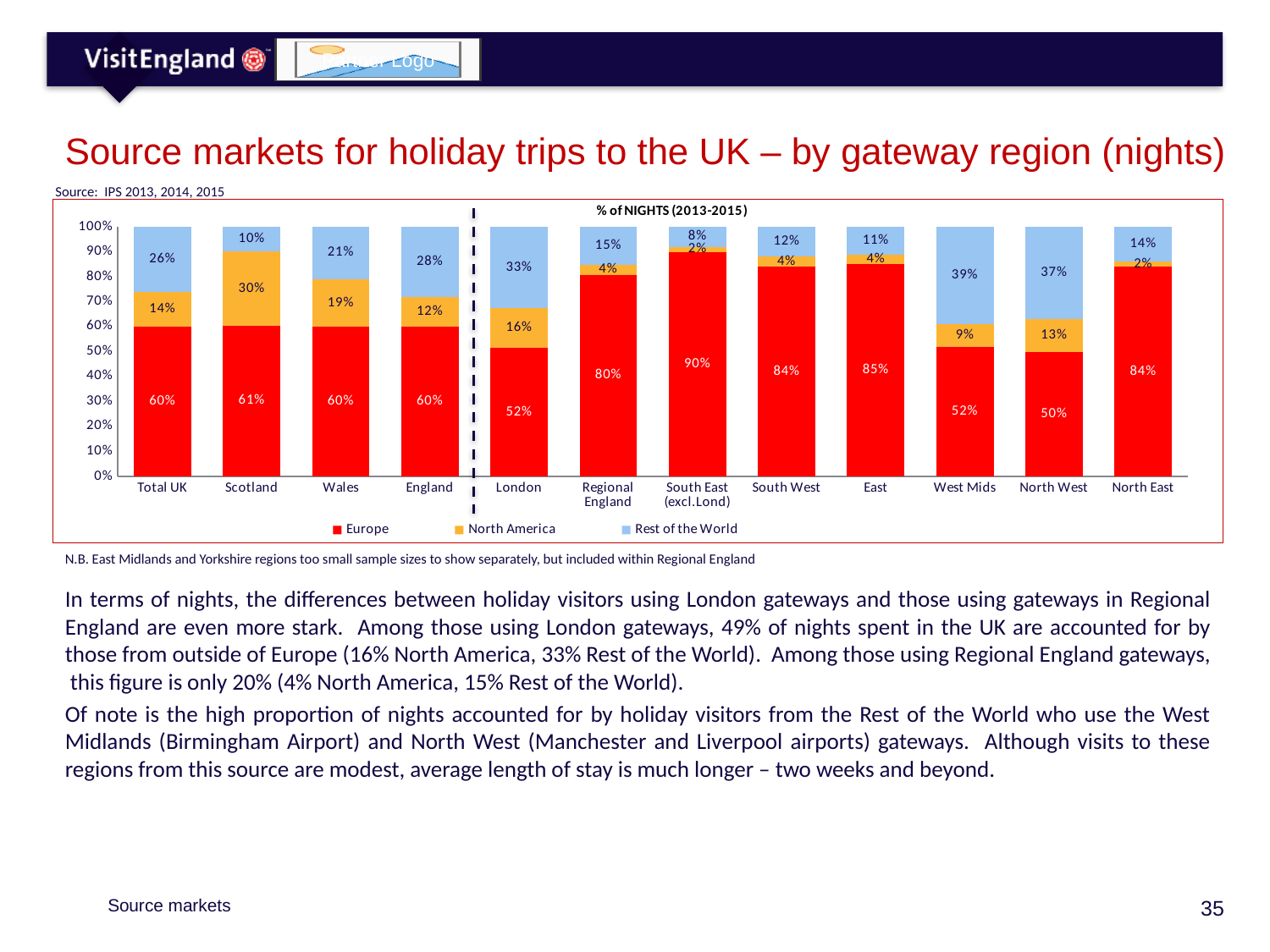
What is the Europe share of nights for London gateways? 52% What is the title of the chart? % of NIGHTS (2013-2015) What is the North America share of nights for Scotland? 30% How many series does the legend list? 3 What kind of chart is shown on the slide? Stacked bar chart Which gateway region has the highest Europe share of nights? South East (excl.Lond) Which has a larger North America share of nights, Wales or England? Wales What is the Rest of the World share of nights for West Mids? 39% What is the Rest of the World share of nights for Regional England? 15% Which gateway region has the lowest Europe share of nights? North West What is the difference between the Rest of the World share for London and for Regional England? 18 percentage points How many gateway regions (categories) are shown on the x axis? 12